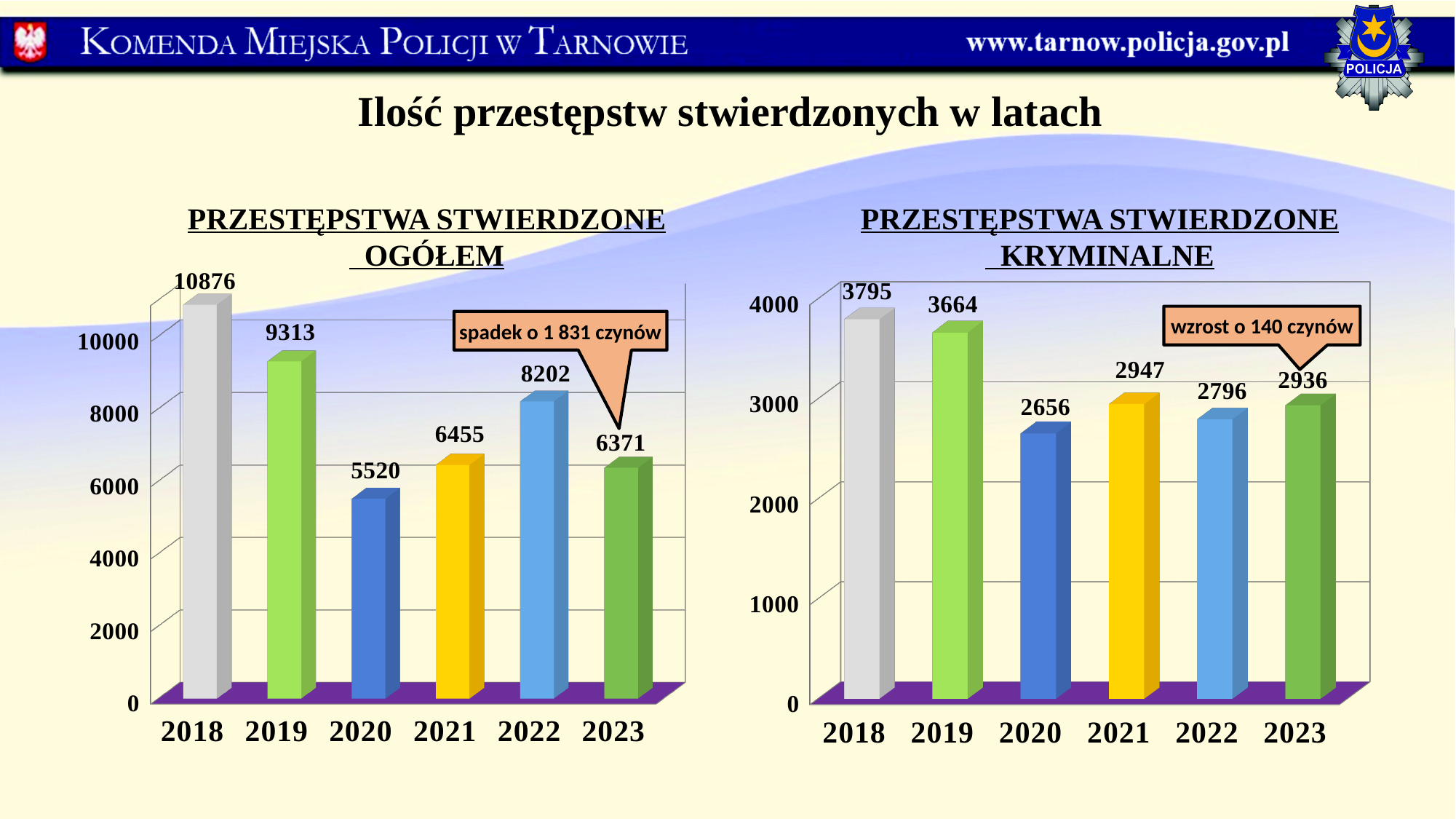
In the chart 'PRZESTĘPSTWA STWIERDZONE KRYMINALNE', what is the difference between the values for 2023 and 2022? 140 In the chart 'PRZESTĘPSTWA STWIERDZONE OGÓŁEM', what is the value for 2018? 10876 In the chart 'PRZESTĘPSTWA STWIERDZONE OGÓŁEM', which year has the lowest value? 2020 In the chart 'PRZESTĘPSTWA STWIERDZONE KRYMINALNE', which year has the lowest value? 2020 In the chart 'PRZESTĘPSTWA STWIERDZONE KRYMINALNE', is the value for 2019 larger or smaller than the value for 2021? larger What kind of chart is 'PRZESTĘPSTWA STWIERDZONE OGÓŁEM'? bar chart In the chart 'PRZESTĘPSTWA STWIERDZONE KRYMINALNE', which year has the highest value? 2018 In the chart 'PRZESTĘPSTWA STWIERDZONE KRYMINALNE', what is the value for 2023? 2936 In the chart 'PRZESTĘPSTWA STWIERDZONE OGÓŁEM', what is the difference between the values for 2022 and 2023? 1831 In the chart 'PRZESTĘPSTWA STWIERDZONE OGÓŁEM', what is the value for 2022? 8202 In the chart 'PRZESTĘPSTWA STWIERDZONE OGÓŁEM', how many years are shown on the x axis? 6 In the chart 'PRZESTĘPSTWA STWIERDZONE KRYMINALNE', what is the value for 2021? 2947